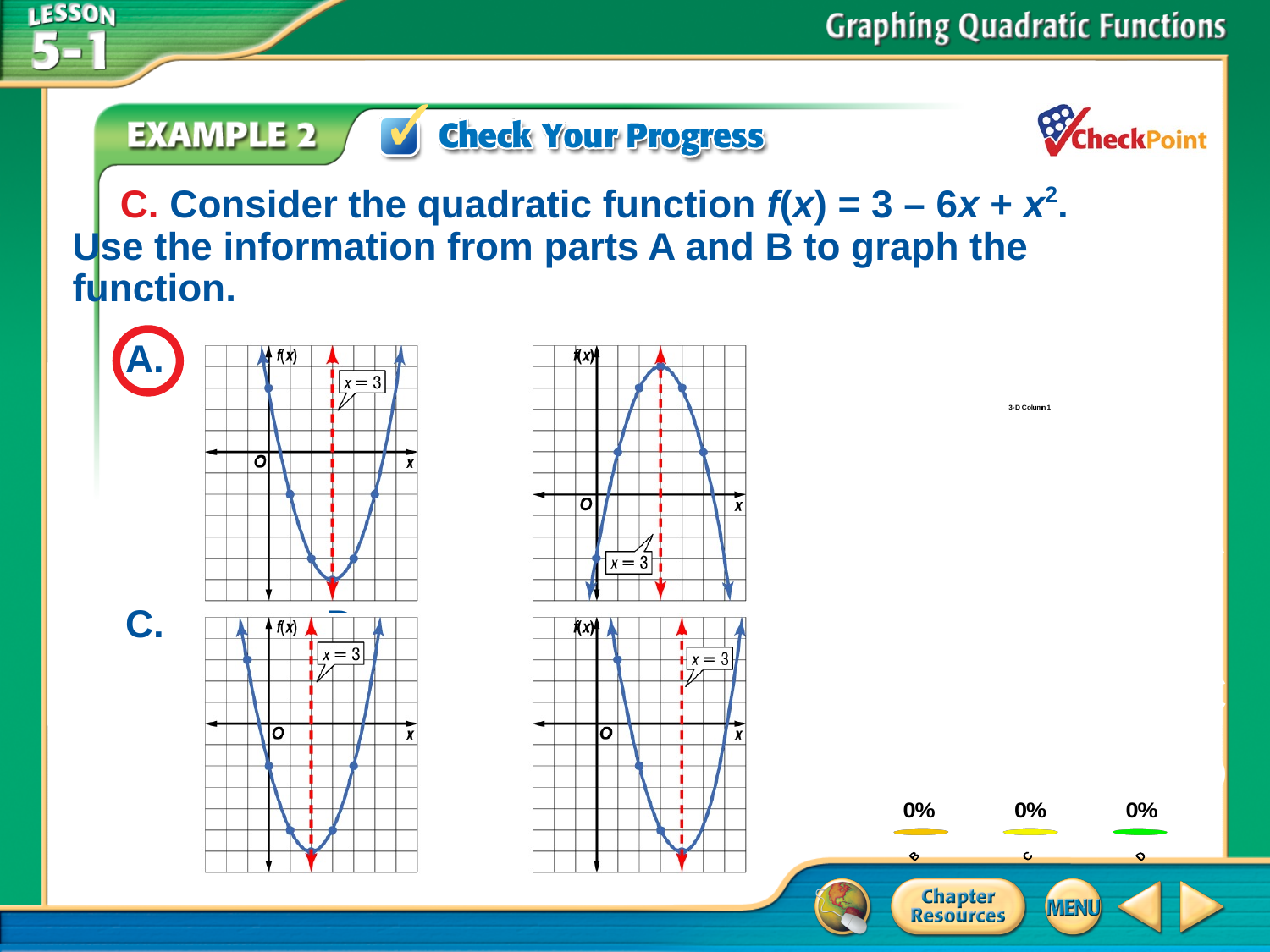
In the bar chart at the bottom right, what is the value for category D? 0% In the bar chart at the bottom right, what are the category labels along the x axis? B, C, D What kind of chart is shown at the bottom right of the slide? bar chart In the bar chart at the bottom right, how many categories are shown? 3 In the bar chart at the bottom right, what is the value for category C? 0% In the bar chart at the bottom right, what is the value for category B? 0% In the bar chart at the bottom right, what is the difference between the values for B and D? 0% What is the title of the bar chart at the bottom right of the slide? 3-D Column 1